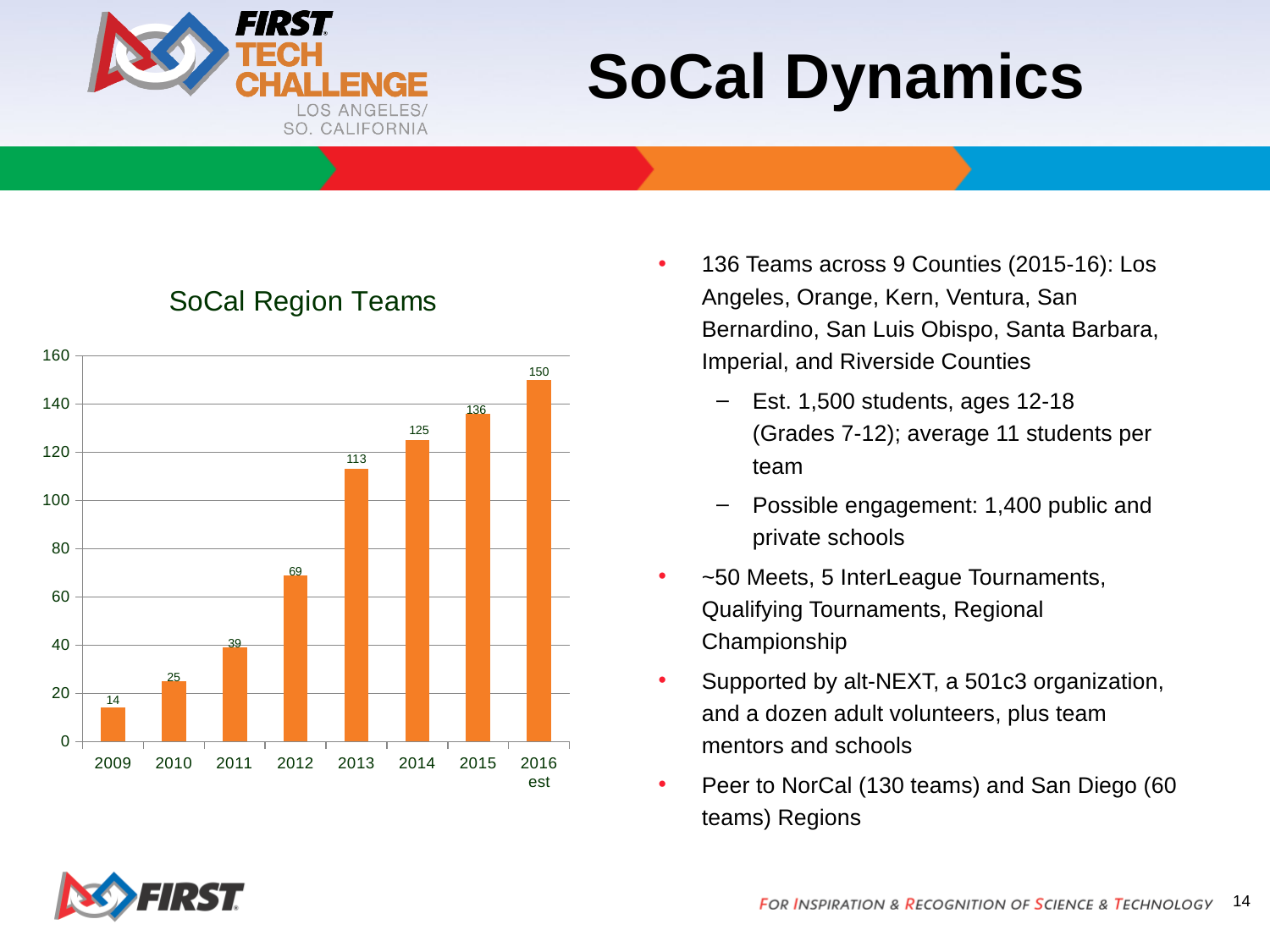
Is the value for 2014 greater or less than 120 in the SoCal Region Teams chart? greater What is the value for 2016 est in the SoCal Region Teams chart? 150 Which is larger in the SoCal Region Teams chart, the value for 2011 or the value for 2010? 2011 How many teams are shown for 2009 in the SoCal Region Teams chart? 14 Which year has the highest value in the SoCal Region Teams chart? 2016 est How many years (categories) are shown in the SoCal Region Teams chart? 8 What kind of chart is the SoCal Region Teams chart? bar chart Which year has the lowest value in the SoCal Region Teams chart? 2009 Do the values in the SoCal Region Teams chart rise or fall from 2009 to 2016 est? rise What is the difference between the 2013 and 2012 values in the SoCal Region Teams chart? 44 What is the difference between the 2015 and 2014 values in the SoCal Region Teams chart? 11 What is the value for 2013 in the SoCal Region Teams chart? 113